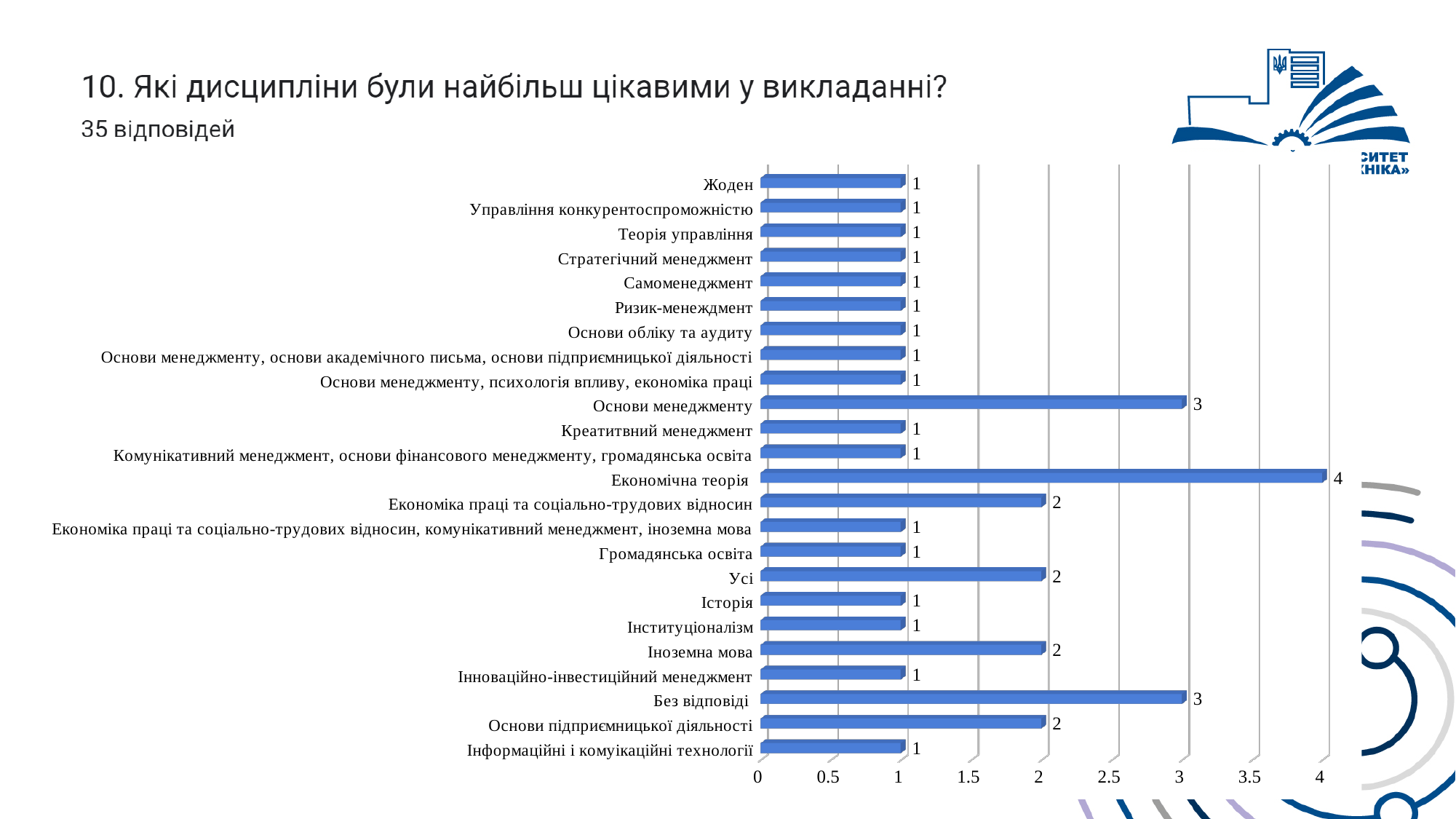
What kind of chart is shown on the slide? bar chart How many categories are shown in the chart? 24 Is the value for Економічна теорія greater or less than 3? greater What is the difference between the values for Без відповіді and Основи підприємницької діяльності? 1 What is the value for Економічна теорія? 4 How many responses does the slide say the chart is based on? 35 відповідей What is the value for Основи менеджменту? 3 What is the difference between the values for Економічна теорія and Основи менеджменту? 1 Which category has the highest value? Економічна теорія Which is larger, the value for Усі or the value for Історія? Усі What is the value for Іноземна мова? 2 What is the value for Без відповіді? 3